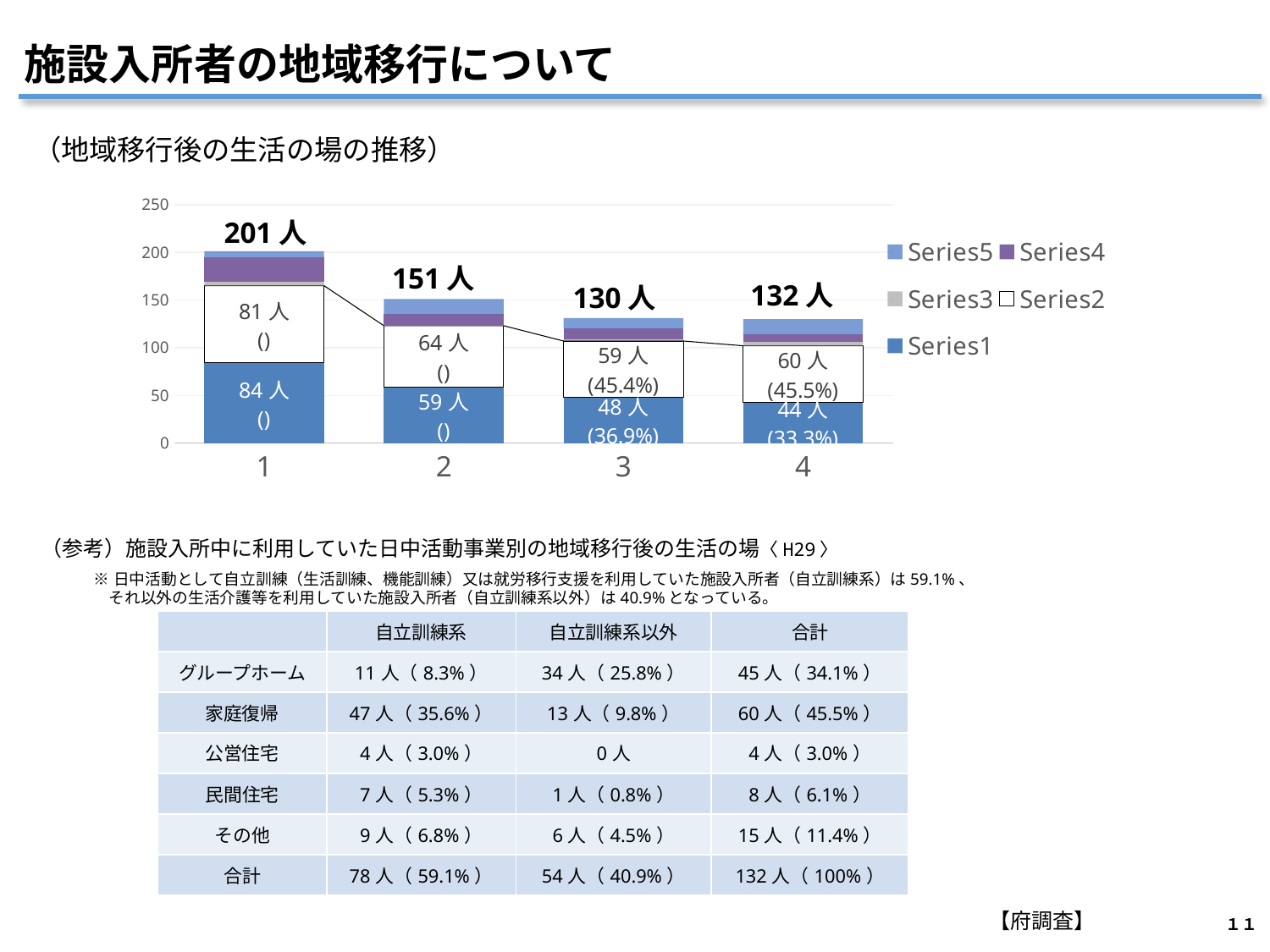
What type of chart is shown on the slide? stacked bar chart What is the total labeled above the bar for category 3? 130人 How many series does the chart legend list? 5 Which category has the highest total? 1 What is the difference between the totals for category 1 and category 2? 50人 How many categories are shown on the x axis of the chart? 4 Do the bar totals generally rise or fall from category 1 to category 3? fall What is the Series1 value for category 2? 59人 Is the Series1 value for category 1 larger or smaller than the Series1 value for category 4? larger Which category has the lowest total? 3 What is the total labeled above the bar for category 1? 201人 What is the Series2 value for category 4? 60人